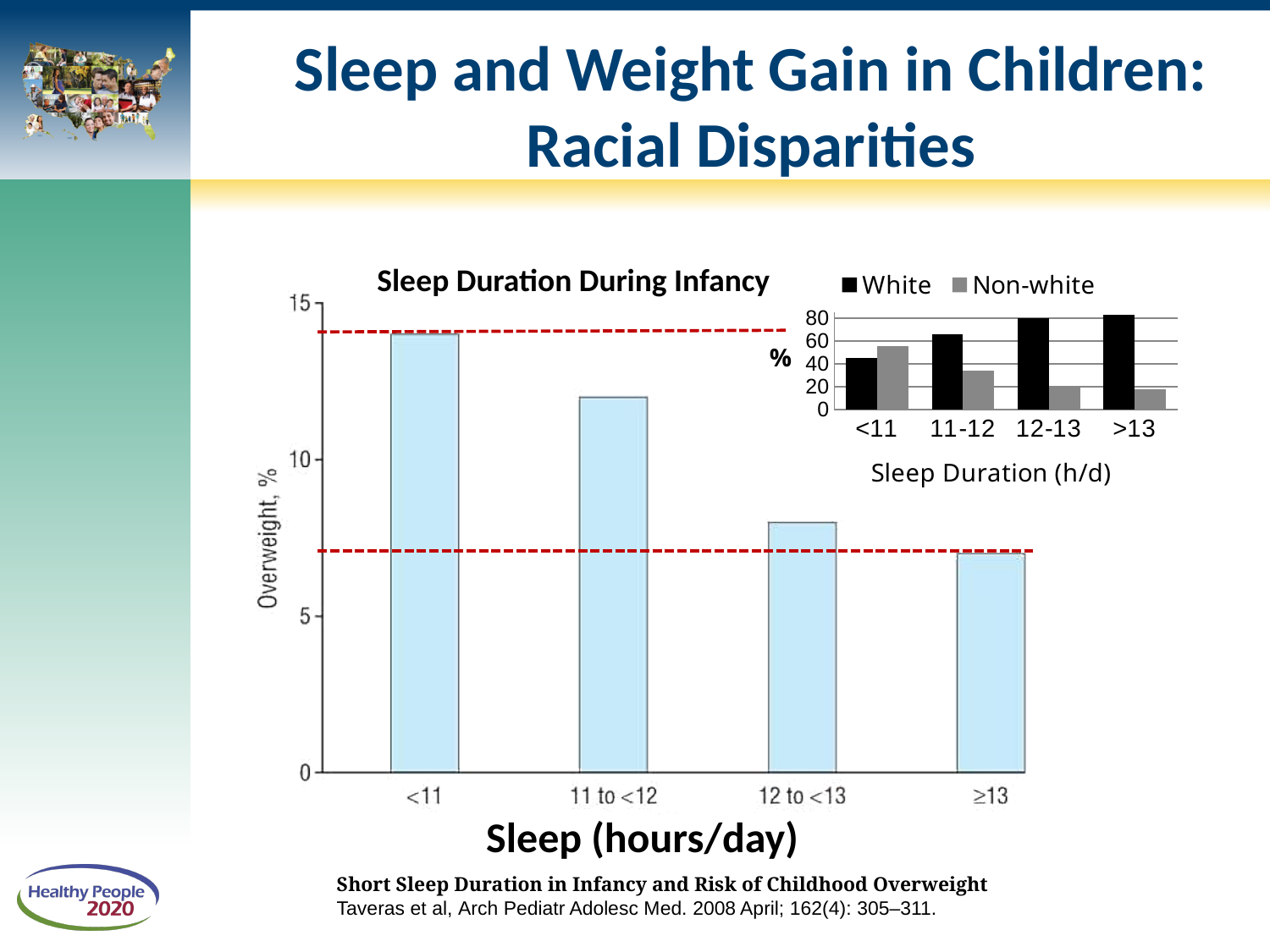
In the inset chart at the top right, how many series does the legend list? 2 In the 'Sleep Duration During Infancy' chart, how many sleep-duration categories are plotted? 4 In the 'Sleep Duration During Infancy' chart, which sleep category has the highest overweight percentage? <11 In the 'Sleep Duration During Infancy' chart, what kind of chart is shown? bar chart In the inset chart at the top right, what is the x-axis title? Sleep Duration (h/d) In the 'Sleep Duration During Infancy' chart, which is larger: the overweight percentage for '11 to <12' or for '≥13'? 11 to <12 In the 'Sleep Duration During Infancy' chart, is the overweight percentage for '<11' greater or less than 10? greater In the inset chart at the top right, is the White value for '>13' greater or less than 60? greater In the 'Sleep Duration During Infancy' chart, is the overweight percentage for '12 to <13' greater or less than 10? less In the inset chart at the top right, which is larger for the '<11' category: White or Non-white? Non-white In the 'Sleep Duration During Infancy' chart, which sleep category has the lowest overweight percentage? ≥13 In the 'Sleep Duration During Infancy' chart, do overweight percentages rise or fall as sleep hours increase along the x axis? fall